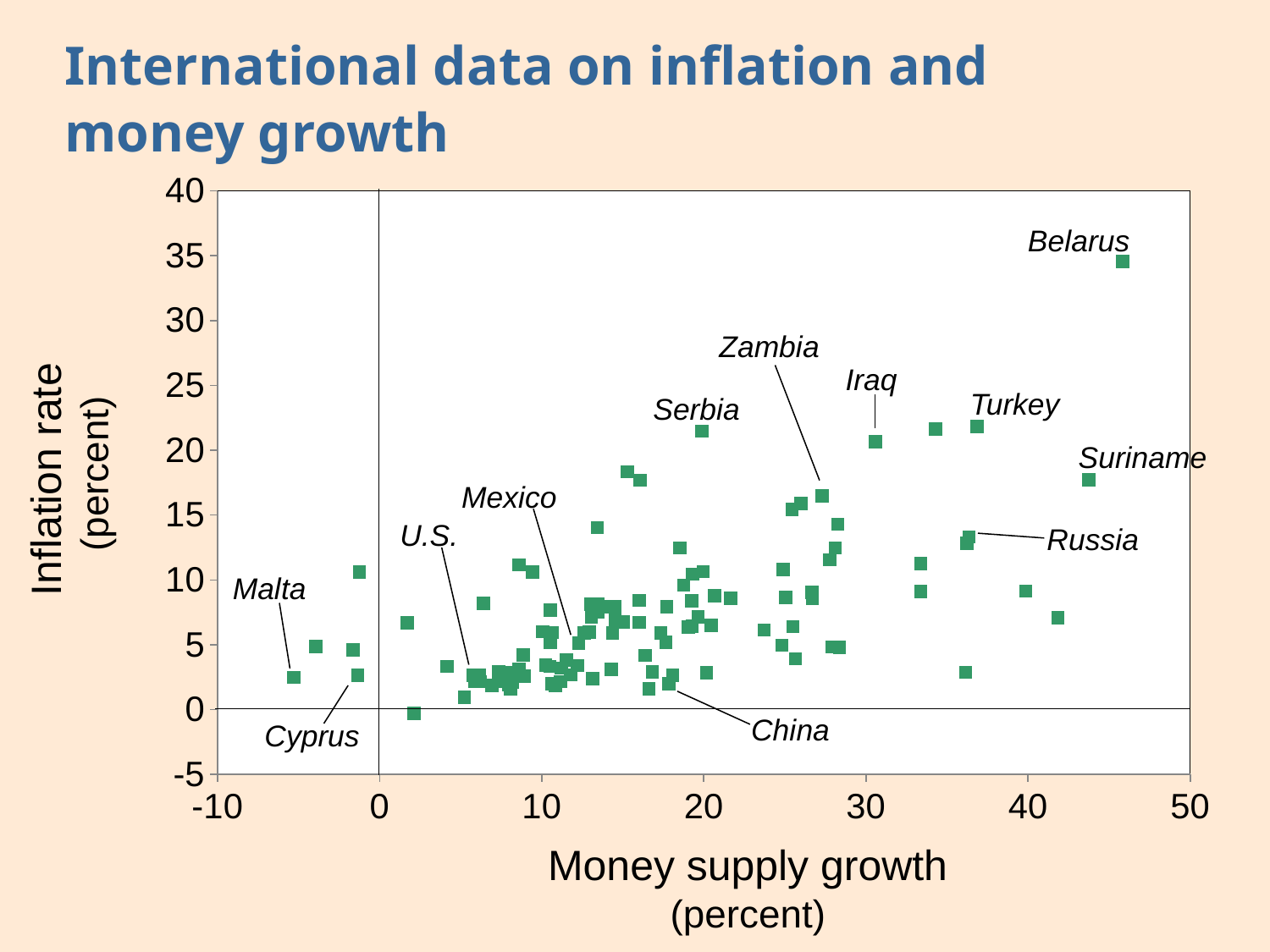
Is the inflation rate for Turkey greater or less than 20? greater Is the inflation rate for Belarus greater or less than 30? greater Is the inflation rate for China greater or less than 5? less What kind of chart is shown on the slide? scatter plot Which labeled country has the lowest money supply growth? Malta Which has the higher money supply growth, Malta or Belarus? Belarus Which labeled country has the highest inflation rate? Belarus What is the label of the horizontal axis? Money supply growth (percent) Which has the higher inflation rate, Belarus or Suriname? Belarus